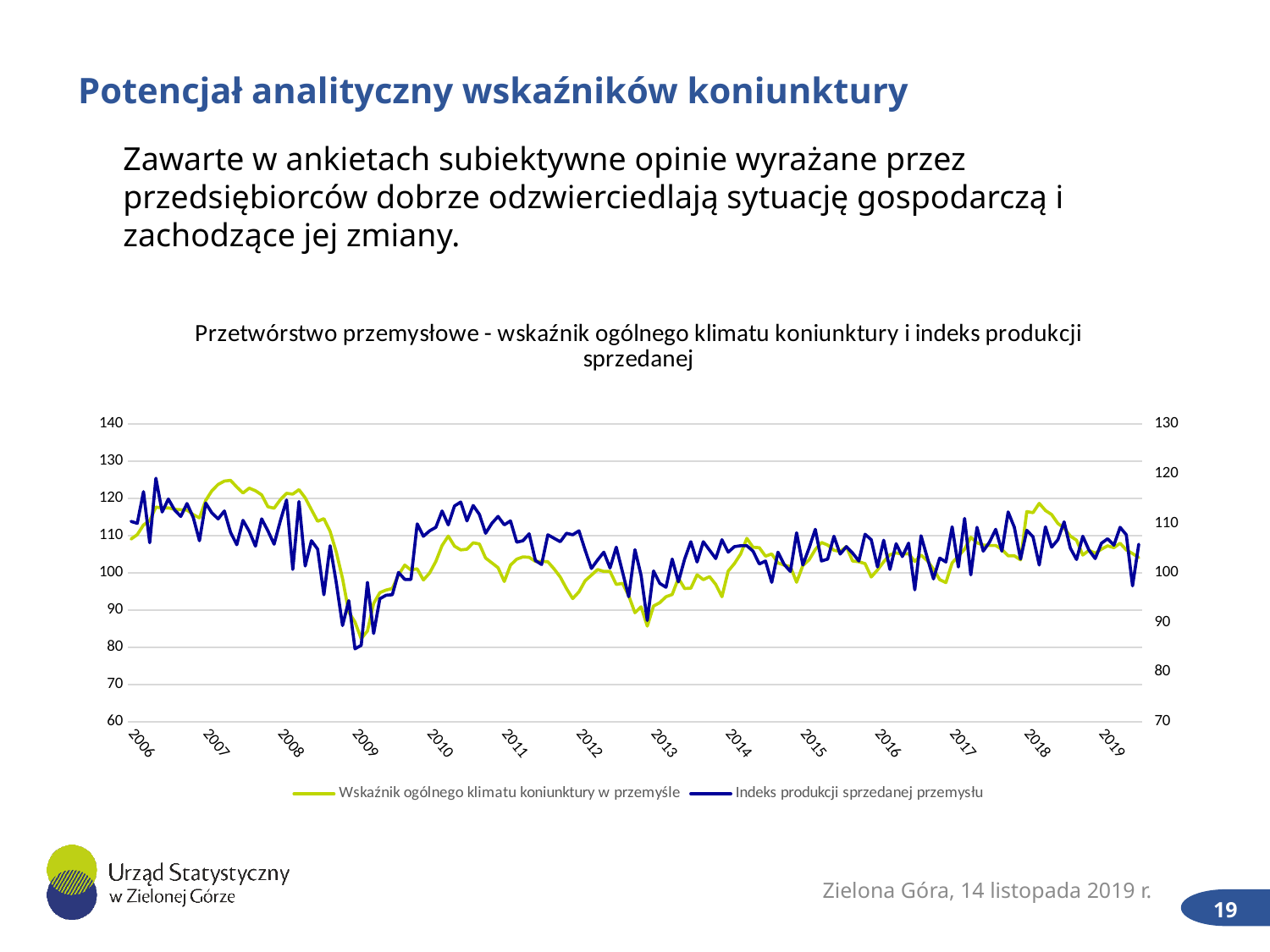
How many year labels are shown on the x axis? 14 What kind of chart is shown on the slide? line chart Does the Wskaźnik ogólnego klimatu koniunktury w przemyśle line rise or fall between 2008 and early 2009? fall Which year is the last label on the x axis? 2019 Is the peak of the Wskaźnik ogólnego klimatu koniunktury w przemyśle line around 2007 greater or less than 110? greater Which year is the first label on the x axis? 2006 Is the lowest value of the Indeks produkcji sprzedanej przemysłu line around 2009 greater or less than 90? less Which series is drawn in dark blue according to the legend? Indeks produkcji sprzedanej przemysłu What is the title of the chart? Przetwórstwo przemysłowe - wskaźnik ogólnego klimatu koniunktury i indeks produkcji sprzedanej Is the value of the Wskaźnik ogólnego klimatu koniunktury w przemyśle line at its lowest point around 2009 greater or less than 100? less Does the Wskaźnik ogólnego klimatu koniunktury w przemyśle line rise or fall between early 2009 and 2010? rise How many series does the legend list? 2